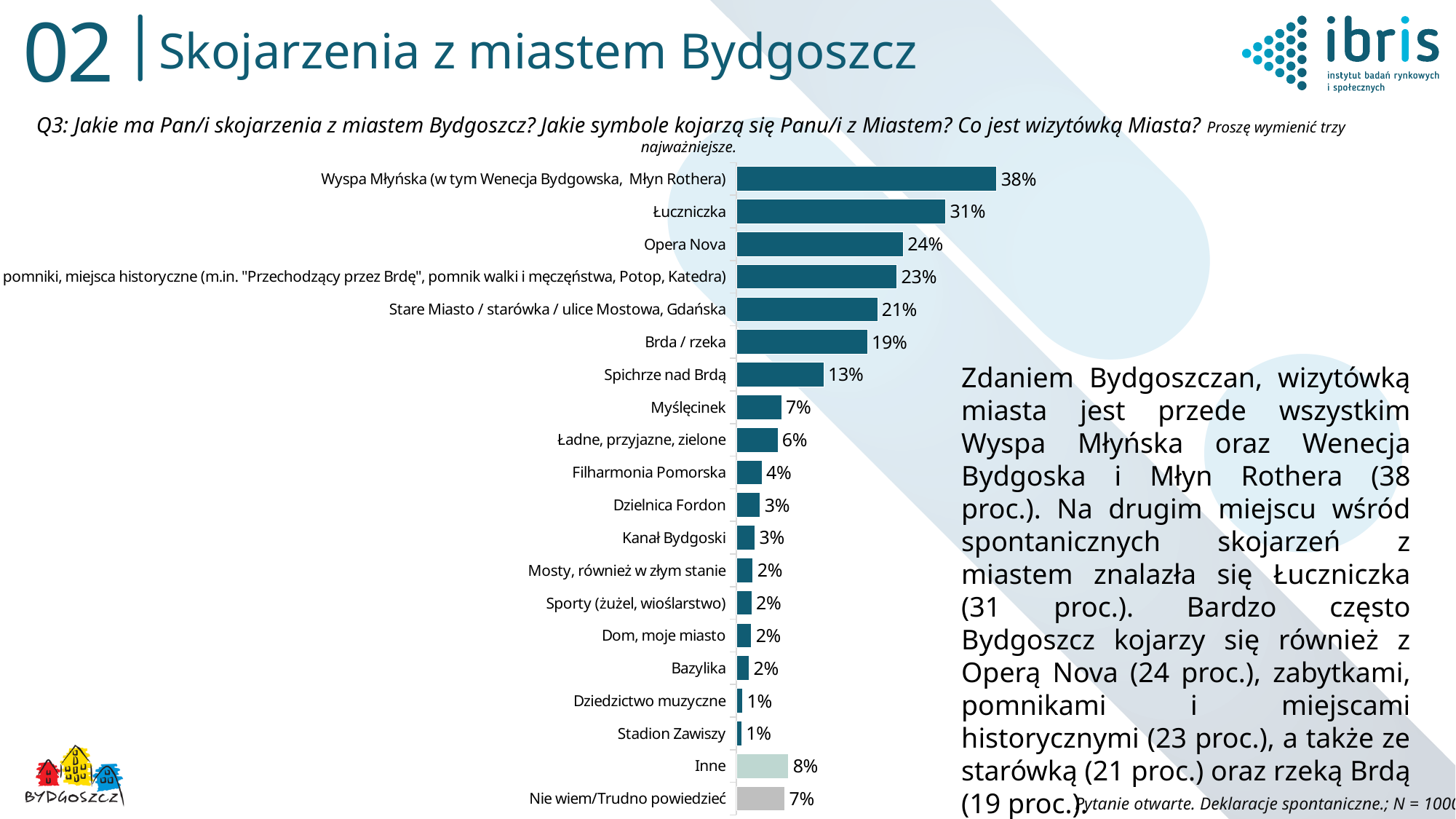
Which is larger, the value for Stare Miasto / starówka / ulice Mostowa, Gdańska or the value for Spichrze nad Brdą? Stare Miasto / starówka / ulice Mostowa, Gdańska What is the value for Filharmonia Pomorska? 4% What is the value for Spichrze nad Brdą? 13% What is the difference between the values for Wyspa Młyńska (w tym Wenecja Bydgowska, Młyn Rothera) and Łuczniczka? 7% What is the value for Nie wiem/Trudno powiedzieć? 7% Which is larger, the value for Myślęcinek or the value for Inne? Inne Which category has the highest value? Wyspa Młyńska (w tym Wenecja Bydgowska, Młyn Rothera) What kind of chart is shown on the slide? Bar chart What is the value for Łuczniczka? 31% What is the value for Dzielnica Fordon? 3% What is the difference between the values for Opera Nova and Brda / rzeka? 5% How many categories are shown in the chart? 20